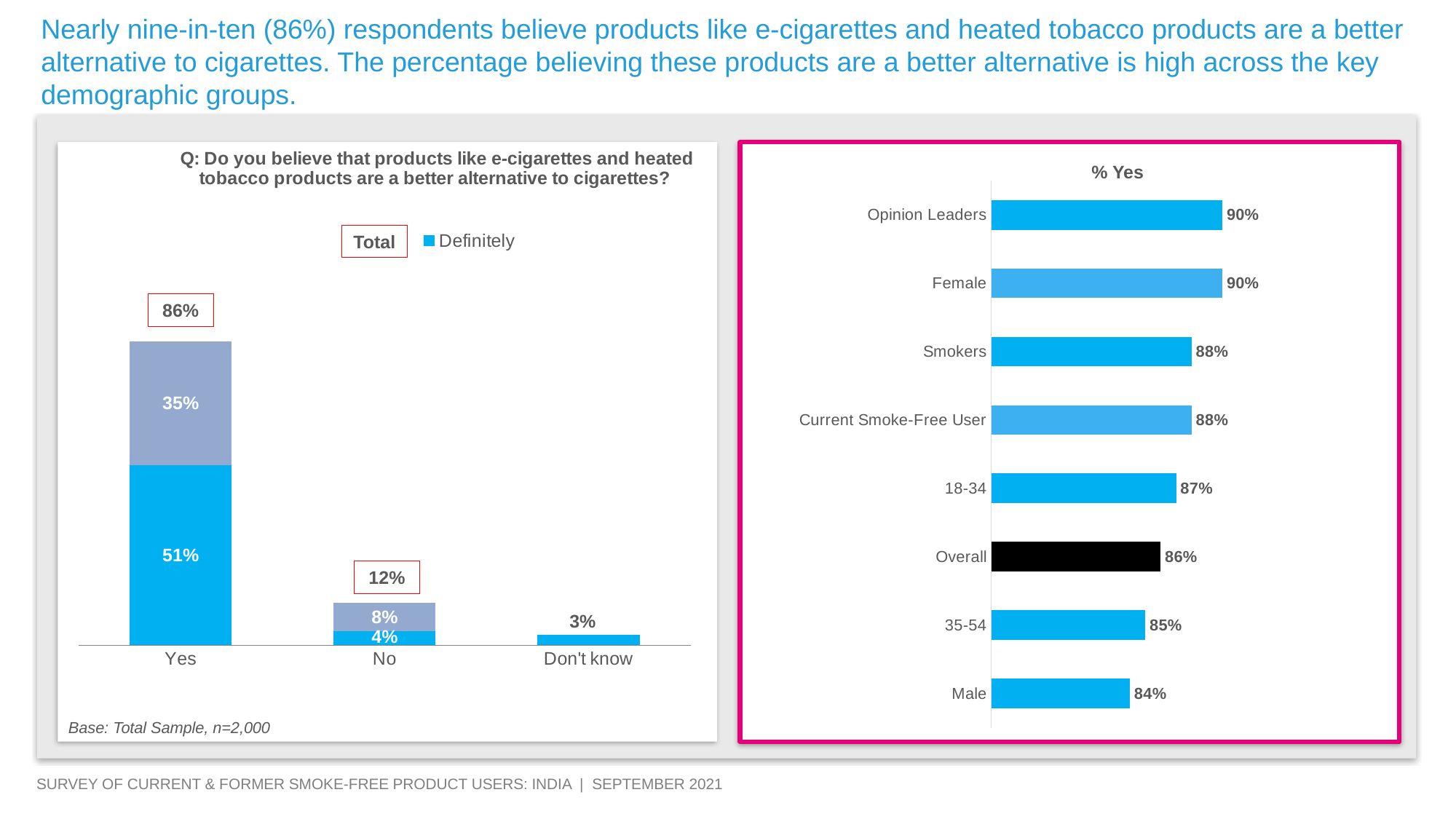
In the '% Yes' chart, what is the difference between Female and Male? 6% What type of chart is the '% Yes' chart? Bar chart In the left chart, how many response categories are shown on the x axis? 3 In the '% Yes' chart, which group has the lowest value? Male In the left chart, what is the difference between the 'Yes' total and the 'No' total? 74% In the left chart, what is the 'Definitely' value for 'Yes'? 51% In the left chart, what is the total percentage for 'Yes'? 86% In the '% Yes' chart, how many groups are plotted? 8 In the left chart, what is the value for 'Don't know'? 3% In the '% Yes' chart, what is the value for Smokers? 88% In the left chart, what is the sum of the two segments of the 'No' bar? 12% In the '% Yes' chart, which is larger: 18-34 or 35-54? 18-34